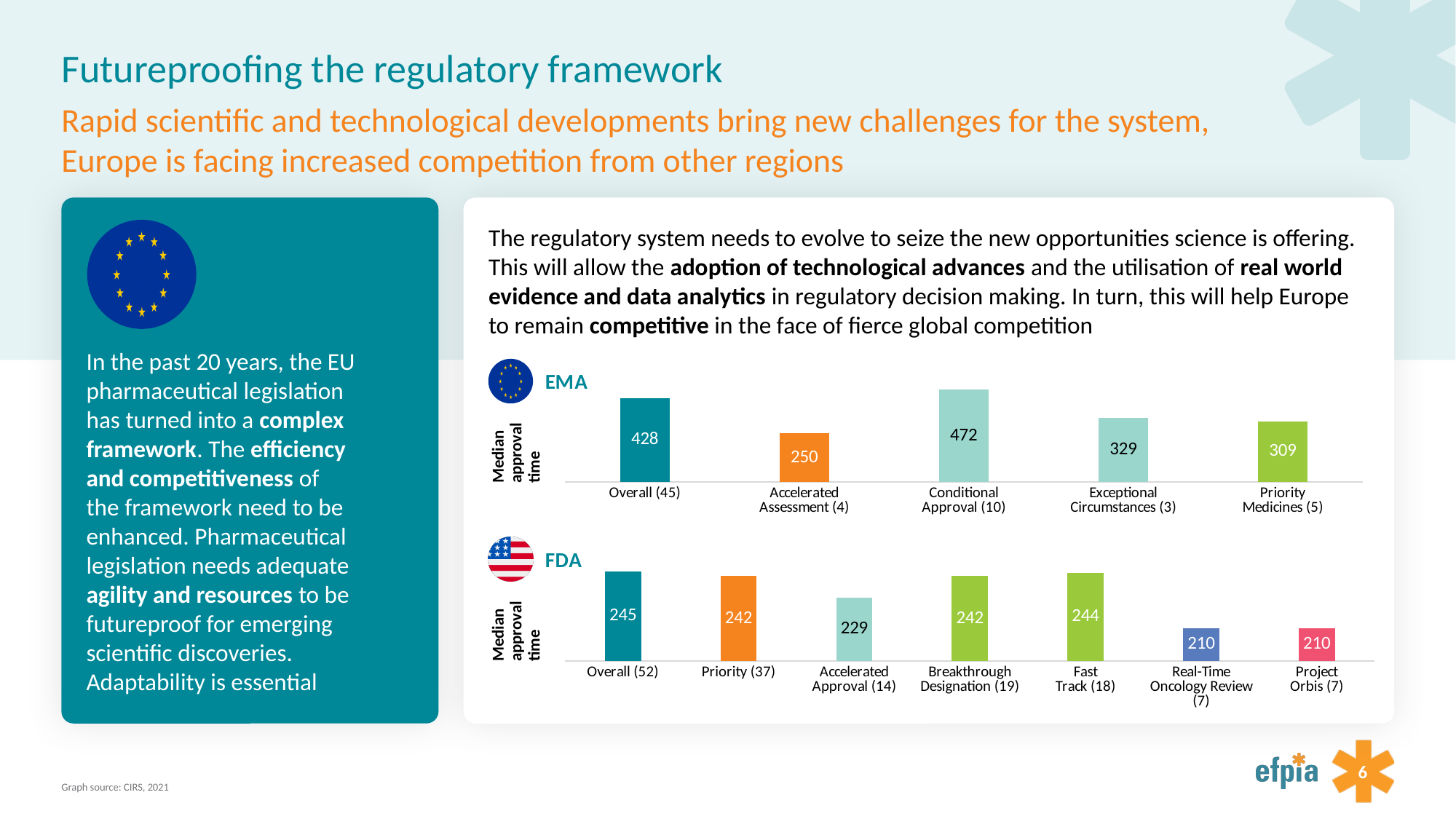
In the FDA chart, what is the median approval time for Real-Time Oncology Review (7)? 210 In the EMA chart, which category has the lowest median approval time? Accelerated Assessment (4) In the EMA chart, what is the median approval time for Conditional Approval (10)? 472 In the EMA chart, what is the difference between the median approval time for Overall (45) and Priority Medicines (5)? 119 In the FDA chart, what is the difference between the median approval time for Overall (52) and Project Orbis (7)? 35 In the FDA chart, what is the median approval time for Accelerated Approval (14)? 229 In the FDA chart, which category has the highest median approval time? Overall (52) In the EMA chart, how many categories are shown? 5 In the FDA chart, how many categories are shown? 7 What type of chart is the FDA chart? Bar chart In the EMA chart, which category has the highest median approval time? Conditional Approval (10) In the EMA chart, what is the median approval time for Accelerated Assessment (4)? 250